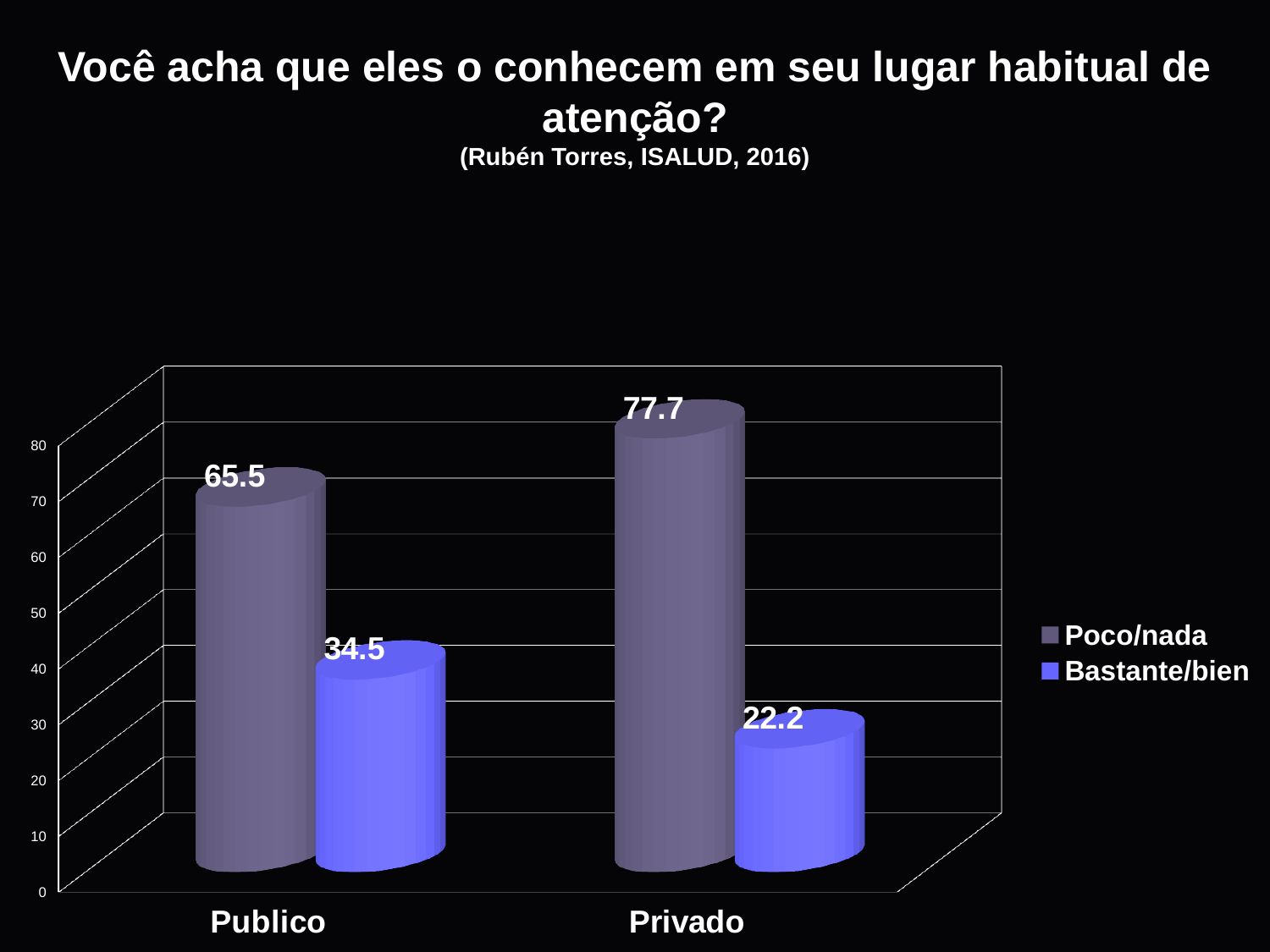
How many series does the legend list? 2 How many categories are shown on the x axis? 2 Which category has the lowest Bastante/bien value? Privado Which is larger: Bastante/bien for Publico or Bastante/bien for Privado? Publico What is the difference between the Poco/nada and Bastante/bien values for Publico? 31 What is the value for Poco/nada in the Publico category? 65.5 Which category has the highest Poco/nada value? Privado What is the value for Poco/nada in the Privado category? 77.7 What is the value for Bastante/bien in the Publico category? 34.5 What kind of chart is shown on the slide? Bar chart What is the difference between the Poco/nada values for Privado and Publico? 12.2 What is the value for Bastante/bien in the Privado category? 22.2